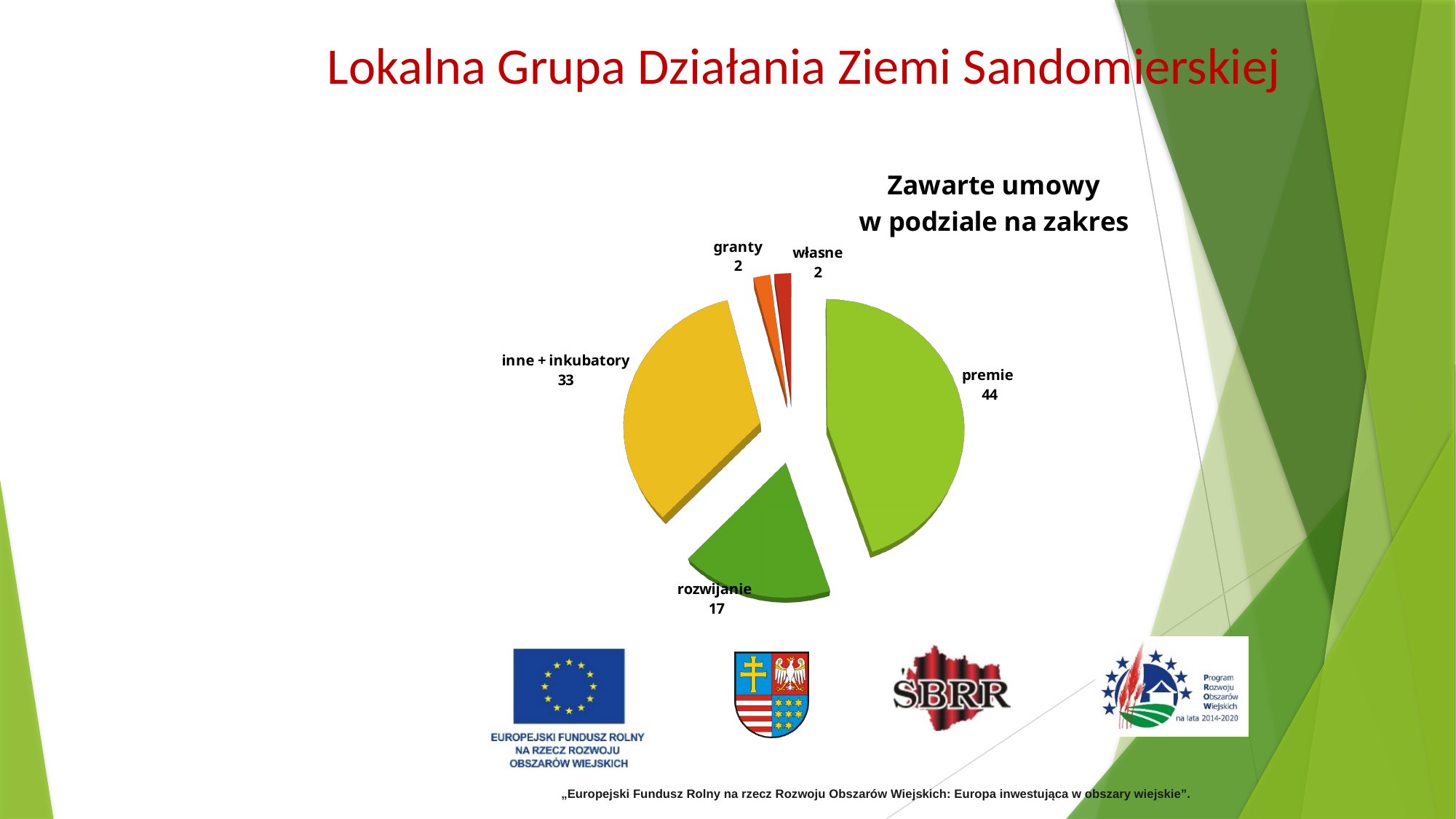
Which category has the largest slice? premie Which is larger, rozwijanie or inne + inkubatory? inne + inkubatory What is the value for granty? 2 What is the value for premie? 44 Which categories have the smallest value in the pie chart? granty and własne How many slices does the pie chart have? 5 What is the title of the chart? Zawarte umowy w podziale na zakres What is the difference between the values for premie and inne + inkubatory? 11 What is the value for inne + inkubatory? 33 What is the value for rozwijanie? 17 What type of chart is shown on the slide? pie chart What is the total of all slices in the pie chart? 98